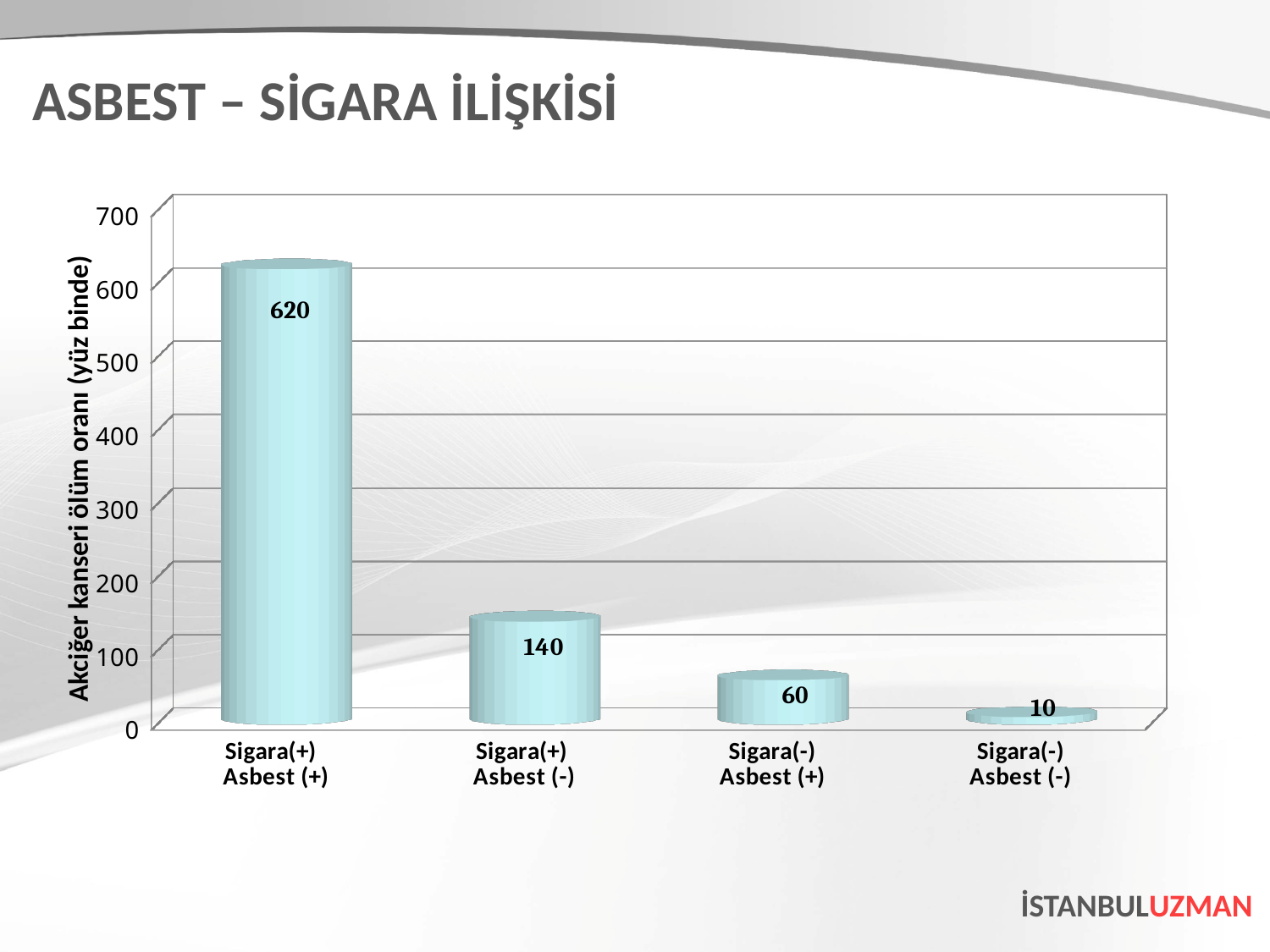
What is the value for Sigara(-) Asbest (-)? 10 What kind of chart is shown on the slide? bar chart What is the value for Sigara(-) Asbest (+)? 60 What is the value for Sigara(+) Asbest (-)? 140 What is the value for Sigara(+) Asbest (+)? 620 Which category has the lowest value? Sigara(-) Asbest (-) How many categories are shown on the chart? 4 What is the label of the vertical axis? Akciğer kanseri ölüm oranı (yüz binde) What is the difference between the values for Sigara(+) Asbest (+) and Sigara(+) Asbest (-)? 480 Is the value for Sigara(+) Asbest (+) greater or less than 600? greater Which is larger, the value for Sigara(+) Asbest (-) or the value for Sigara(-) Asbest (+)? Sigara(+) Asbest (-) Which category has the highest value? Sigara(+) Asbest (+)